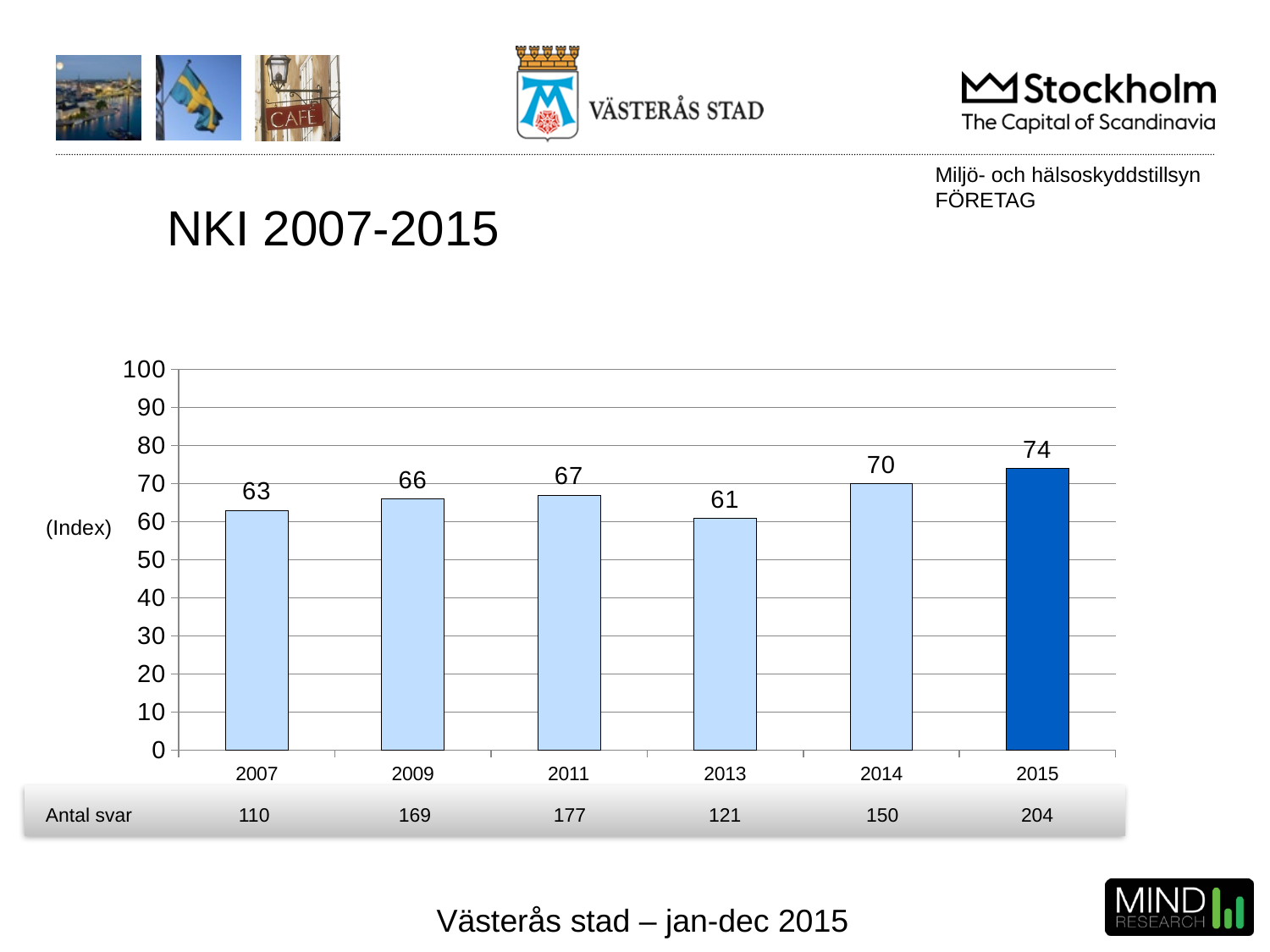
What is the difference between the NKI index values for 2015 and 2007? 11 Which year has the highest NKI index value? 2015 How many years are shown on the x axis of the chart? 6 What is the NKI index value for 2013? 61 What is the 'Antal svar' (number of responses) shown for 2015? 204 Is the NKI index value for 2014 greater or less than 60? greater What kind of chart is shown on the slide? bar chart Which year has a higher NKI index value, 2009 or 2011? 2011 What is the NKI index value for 2007? 63 What is the NKI index value for 2015? 74 Which year has the lowest NKI index value? 2013 What is the difference between the NKI index values for 2014 and 2013? 9